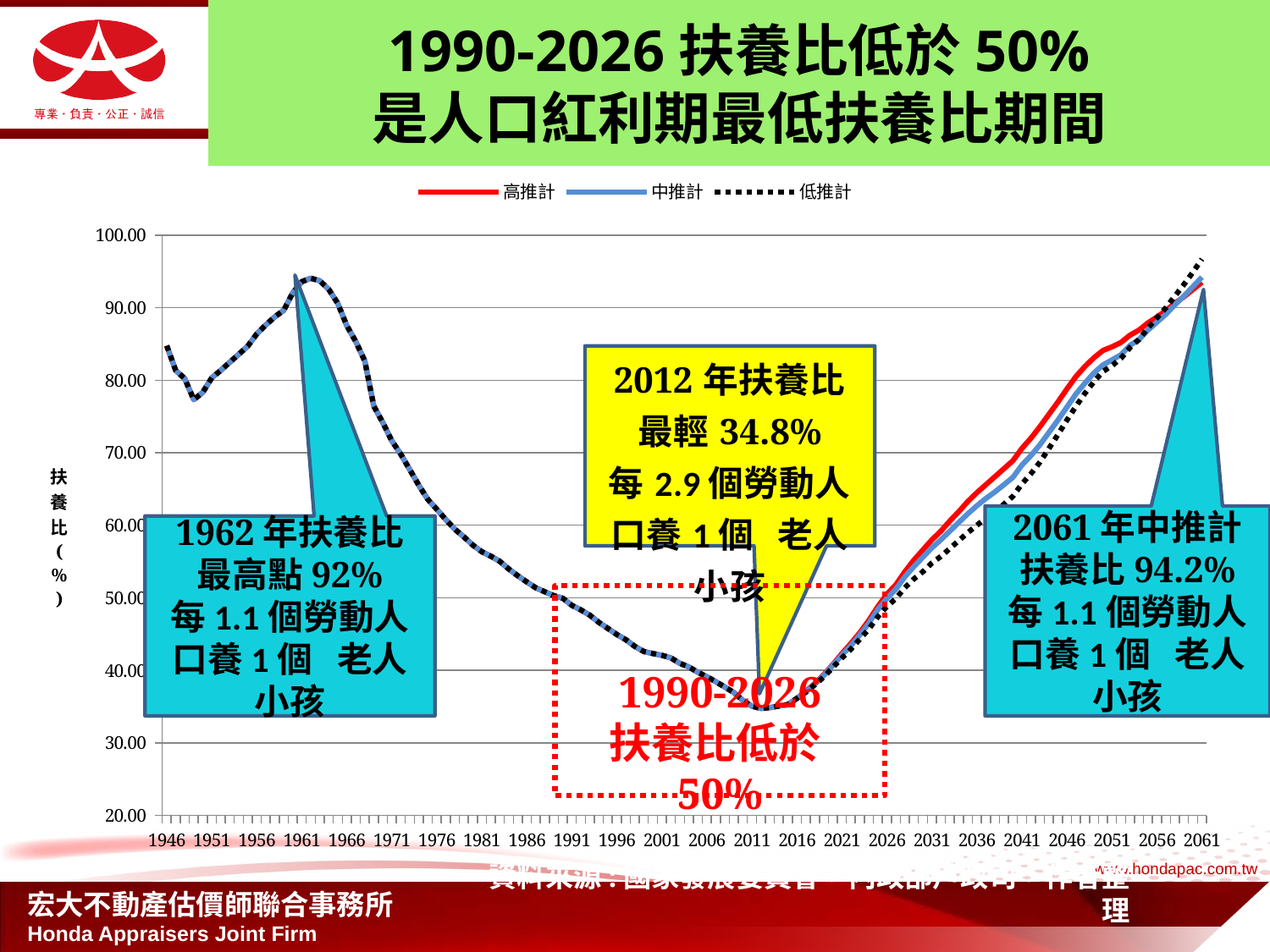
What colour is the 高推計 line? red According to the callout, what is the 中推計 dependency ratio for 2061? 94.2% According to the callout, what was the dependency ratio at its highest point in 1962? 92% What kind of chart is shown on the slide? line chart Is the dependency ratio in 2001 greater or less than 50? less Does the dependency ratio rise or fall between 1962 and 2012? fall How many series does the legend list? 3 Is the dependency ratio in 1946 greater or less than 80? greater According to the callout, what was the dependency ratio (扶養比) in 2012? 34.8% What is the difference between the 2061 中推計 dependency ratio (94.2%) and the 2012 dependency ratio (34.8%)? 59.4 percentage points Which is larger, the dependency ratio in 1962 or in 2012? 1962 Which series is drawn as a black dotted line? 低推計